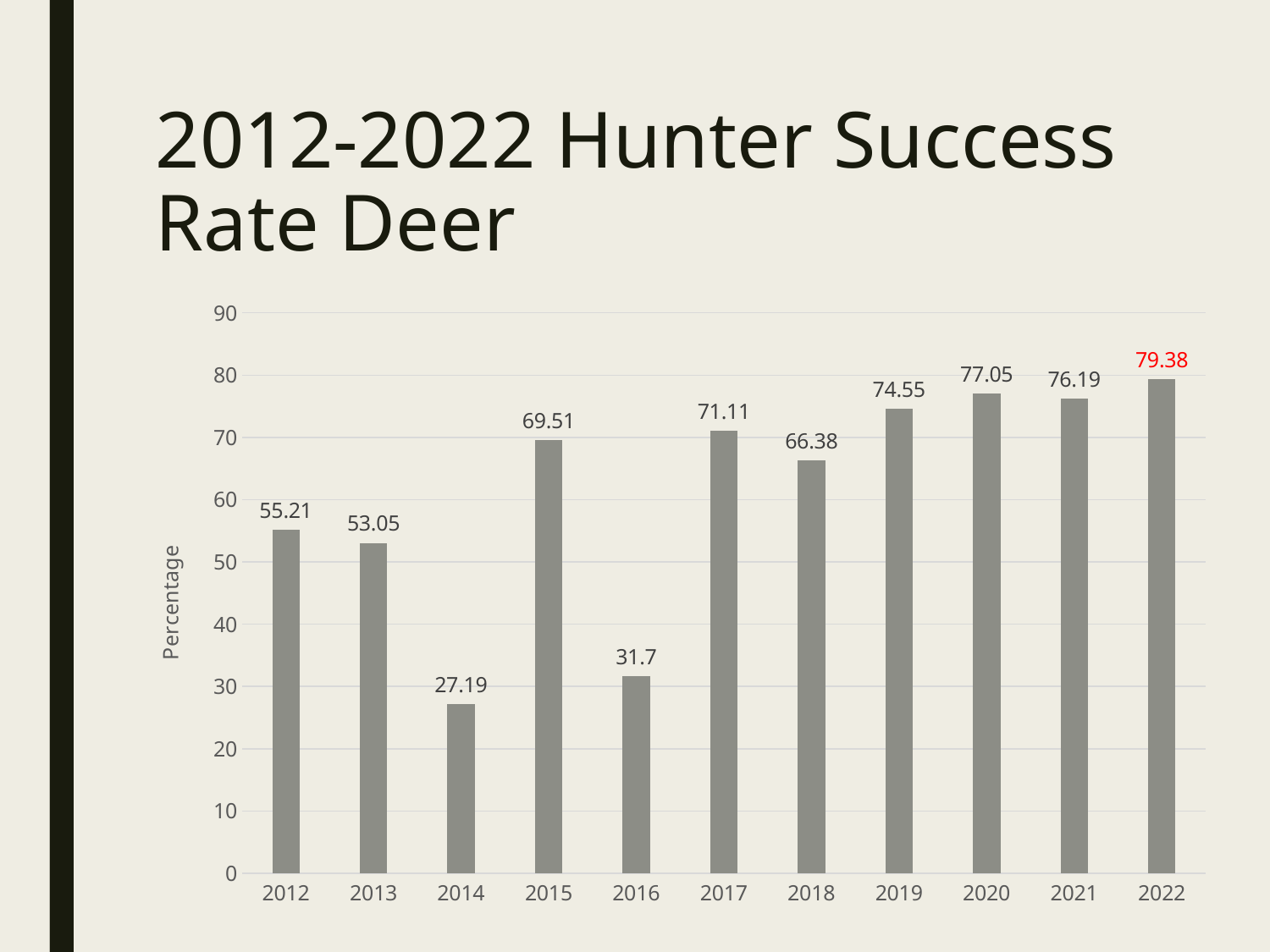
What is the difference between the hunter success rates for 2022 and 2012? 24.17 What is the label on the vertical axis? Percentage How many years are shown on the x axis? 11 What is the hunter success rate for 2014? 27.19 What is the hunter success rate for 2018? 66.38 Is the value for 2019 greater or less than 70? greater Which year has the lowest hunter success rate? 2014 What kind of chart is shown on the slide? Bar chart Which year has the highest hunter success rate? 2022 What is the difference between the hunter success rates for 2016 and 2014? 4.51 Which year has a higher hunter success rate, 2015 or 2017? 2017 What is the hunter success rate for 2022? 79.38